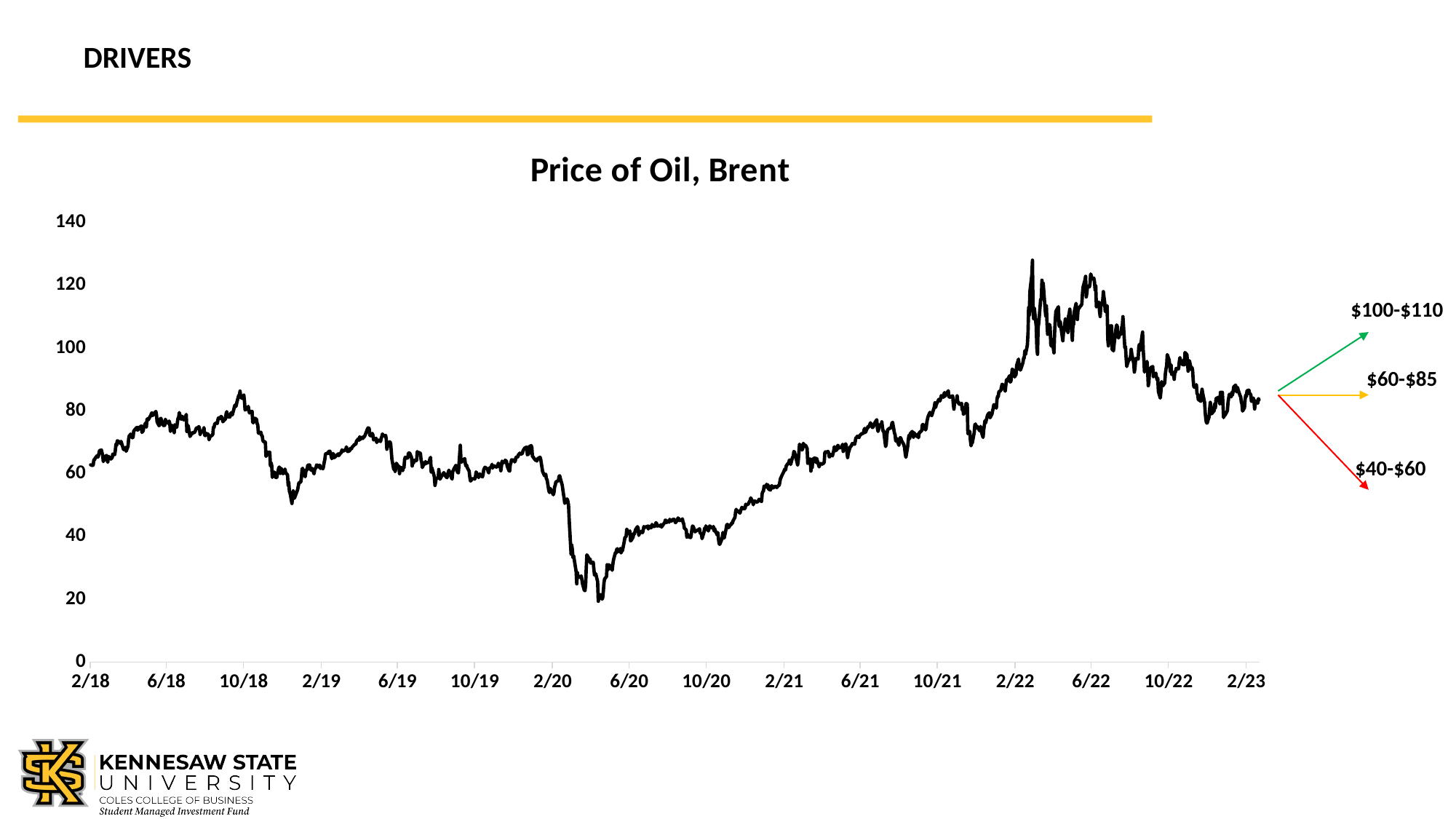
Is the value for 6/22 greater or less than 100? greater How many date labels are shown on the x axis? 16 Does the Brent oil price rise or fall between 6/20 and 2/22? rise Does the Brent oil price rise or fall between 6/22 and 2/23? fall Is the value for 10/20 greater or less than 60? less What kind of chart is shown on the slide? Line chart Is the value for 2/23 greater or less than 60? greater Which is larger, the Brent oil price at 6/22 or at 6/20? 6/22 What is the title of the chart? Price of Oil, Brent What price range is indicated by the green arrow to the right of the chart? $100-$110